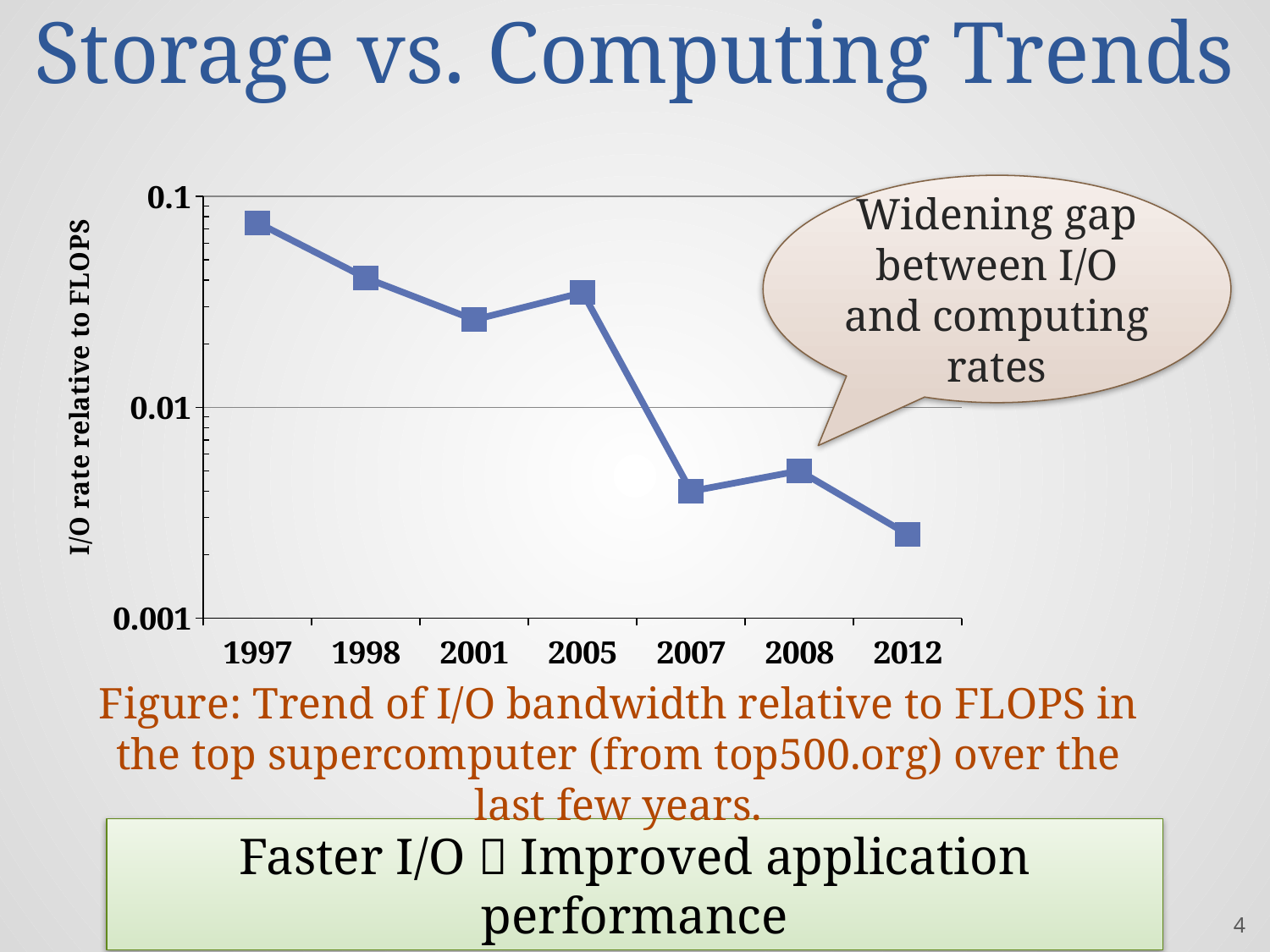
Which year has the lowest I/O rate relative to FLOPS? 2012 Is the value for 2007 greater or less than 0.01? less Which has the higher I/O rate relative to FLOPS, 2001 or 2005? 2005 Is the value for 1997 greater or less than 0.01? greater What kind of chart is shown on the slide? line chart Does the I/O rate relative to FLOPS generally rise or fall from 1997 to 2012? fall Is the value for 2012 greater or less than 0.01? less Which has the higher I/O rate relative to FLOPS, 2007 or 1998? 1998 How many data points are plotted on the chart? 7 What is the label on the vertical axis of the chart? I/O rate relative to FLOPS Which year has the highest I/O rate relative to FLOPS? 1997